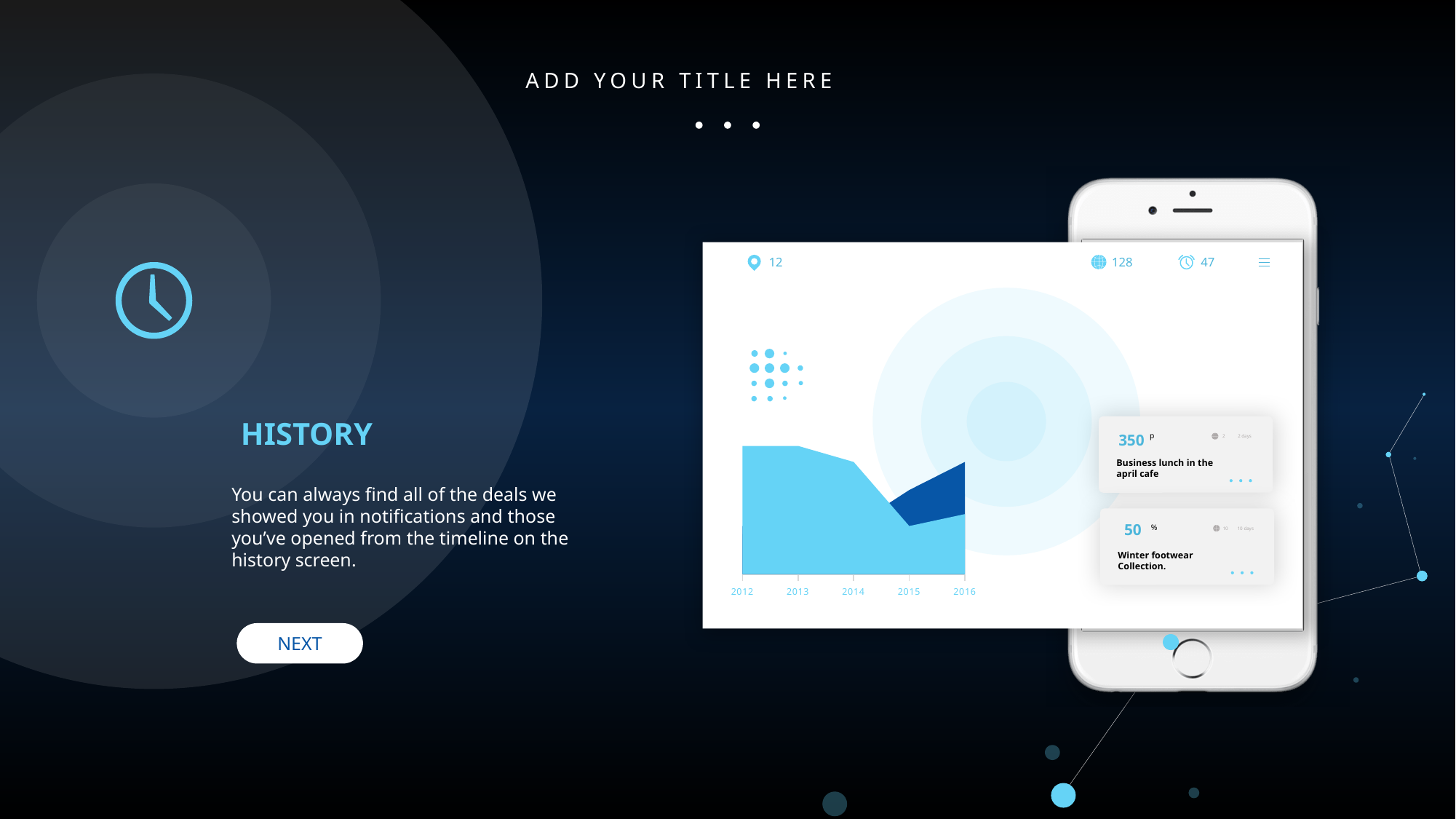
What is the last year labelled on the chart's x axis? 2016 What is the first year labelled on the chart's x axis? 2012 Does the dark blue area rise or fall from 2015 to 2016? rise How many shaded areas (series) are plotted on the chart? 2 In which labelled year is the light blue area at its lowest? 2015 Is the light blue area higher in 2012 or in 2015? 2012 Is the light blue area higher in 2013 or in 2014? 2013 How many years are labelled on the x axis of the chart? 5 What kind of chart is shown on the phone screen? area chart Does the light blue area rise or fall from 2012 to 2015? fall